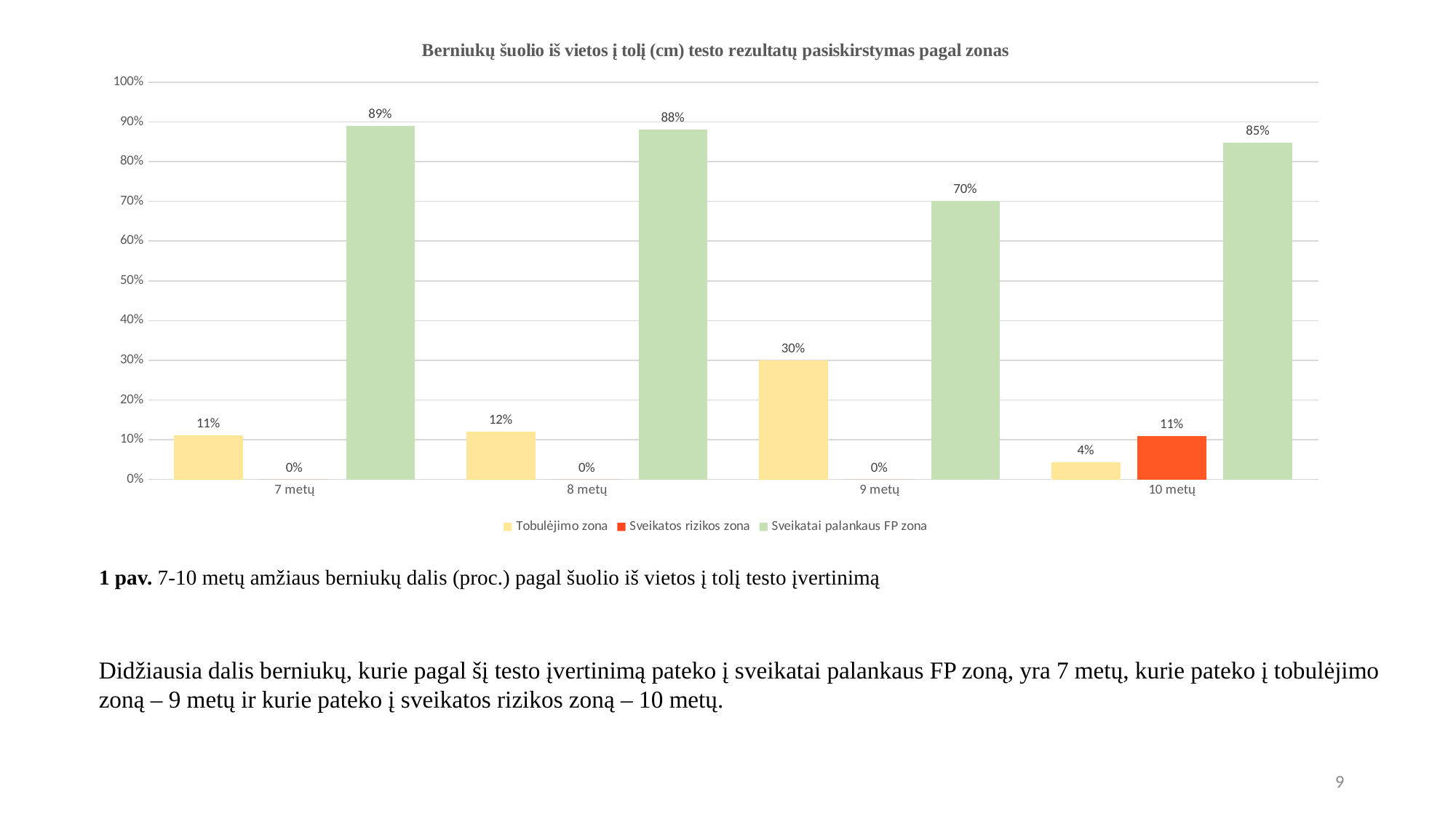
What is the value for Tobulėjimo zona for 9 metų? 30% Which age group has the lowest value for Tobulėjimo zona? 10 metų What is the total of the three zone values for 10 metų? 100% How many age groups are shown on the x axis? 4 What is the value for Sveikatos rizikos zona for 10 metų? 11% What is the difference between the Sveikatai palankaus FP zona values for 7 metų and 9 metų? 19% Which age group has the highest value for Sveikatai palankaus FP zona? 7 metų Is the value for Sveikatai palankaus FP zona for 10 metų greater or less than 80%? greater Which is larger: the Tobulėjimo zona value for 8 metų or for 9 metų? 9 metų What kind of chart is shown on the slide? bar chart How many series does the legend list? 3 What is the value for Sveikatai palankaus FP zona for 7 metų? 89%